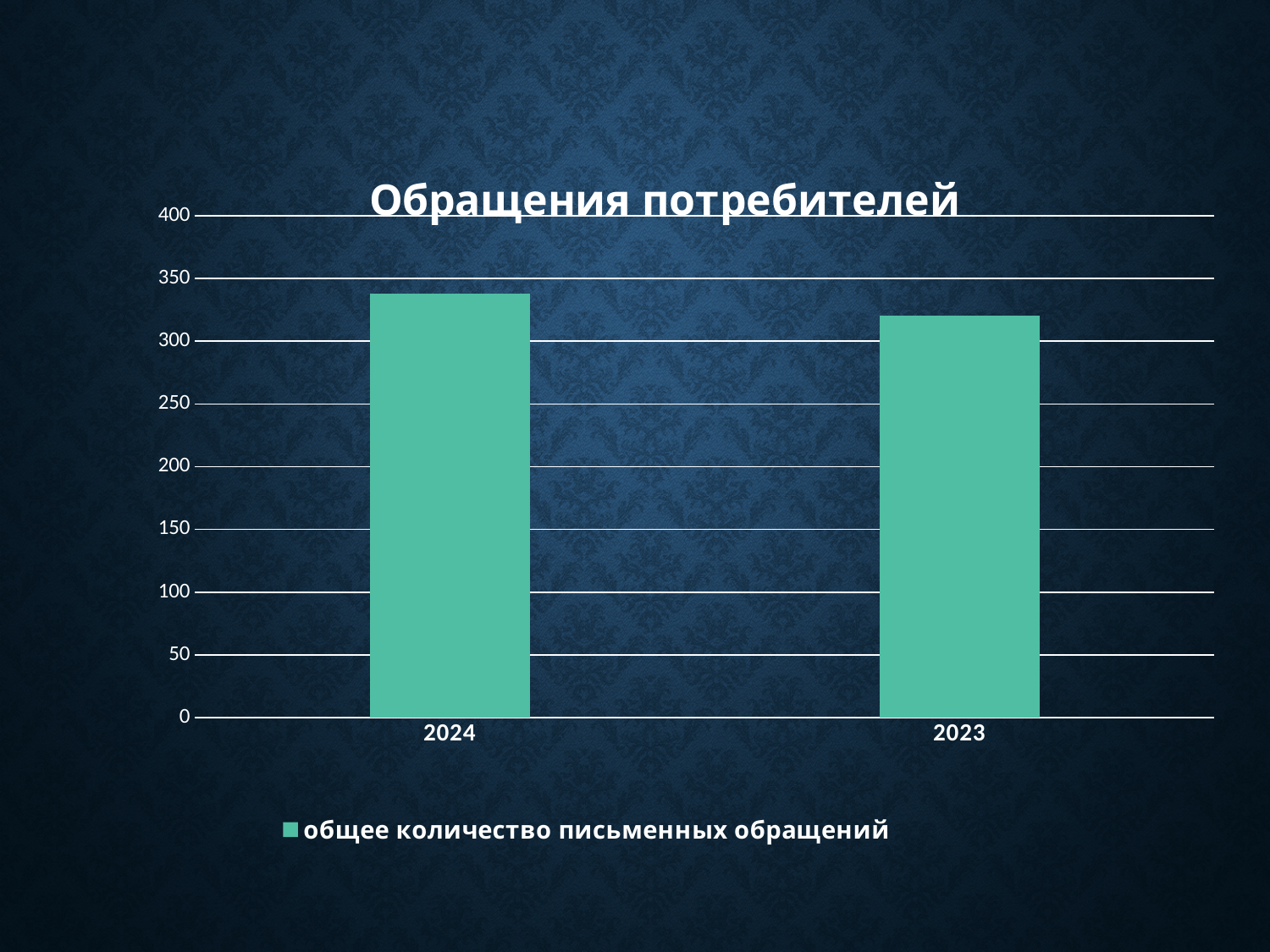
Is the value for 2023 greater or less than 350? less What series name is shown in the legend? общее количество письменных обращений Which year has the lowest bar? 2023 Do the values rise or fall moving from left to right along the x axis? fall Which is larger, the value for 2024 or the value for 2023? 2024 How many categories are shown on the x axis of the chart? 2 How many series does the legend list? 1 Which year has the highest bar? 2024 What is the title of the chart? Обращения потребителей What kind of chart is shown on the slide? bar chart Is the value for 2023 greater or less than 300? greater Is the value for 2024 greater or less than 300? greater